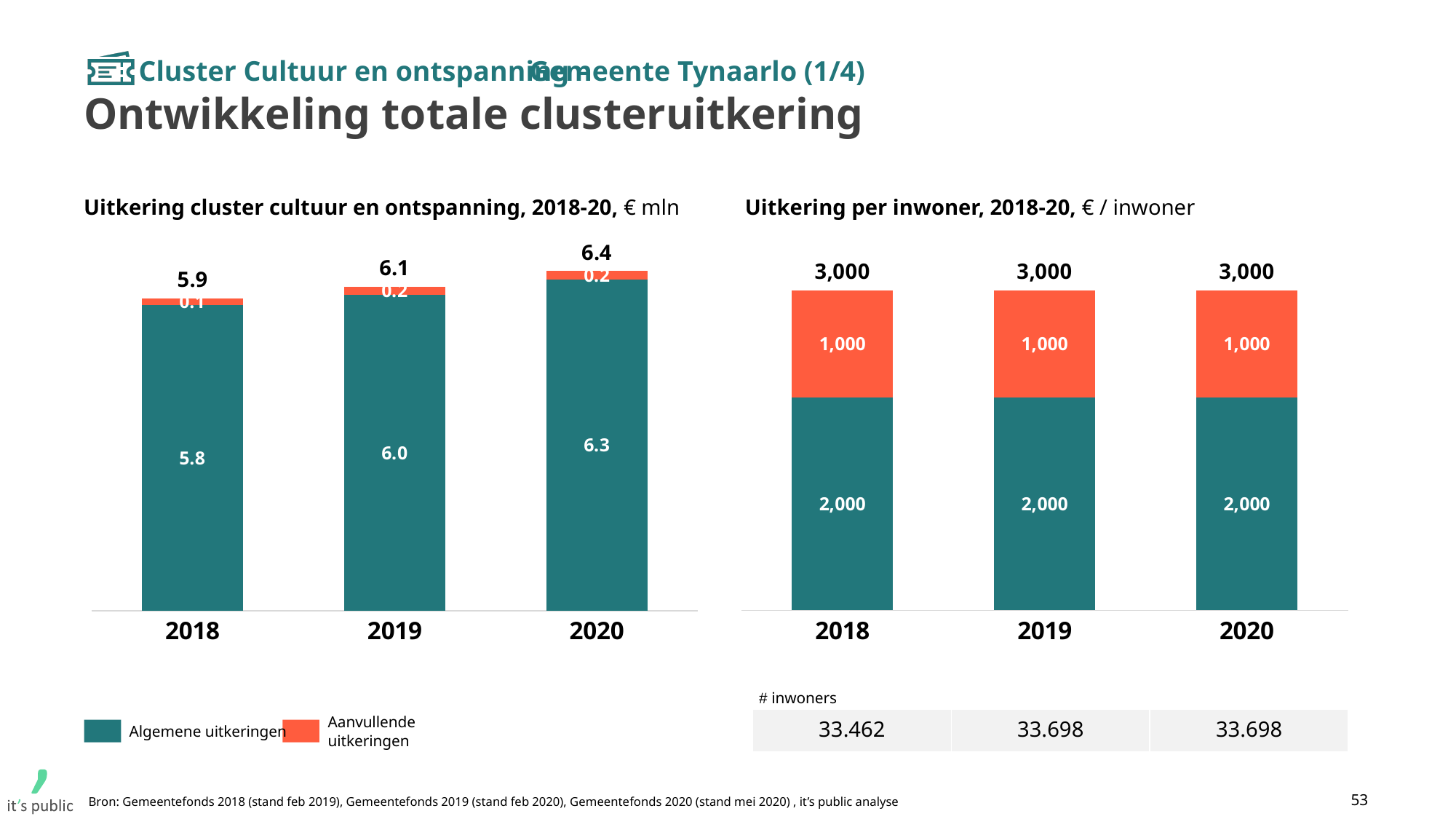
How many years are shown on the x axis of the chart 'Uitkering per inwoner, 2018-20'? 3 What kind of chart is 'Uitkering cluster cultuur en ontspanning, 2018-20'? stacked bar chart In the chart 'Uitkering per inwoner, 2018-20', what is the value of Algemene uitkeringen for 2019? 2,000 How many series does the legend on the slide list? 2 In the chart 'Uitkering cluster cultuur en ontspanning, 2018-20', is Algemene uitkeringen larger in 2019 or in 2018? 2019 In the chart 'Uitkering cluster cultuur en ontspanning, 2018-20', what is the total of the stacked bar for 2019? 6.1 In the chart 'Uitkering cluster cultuur en ontspanning, 2018-20', what is the difference between the total for 2020 and the total for 2018? 0.5 In the chart 'Uitkering cluster cultuur en ontspanning, 2018-20', what is the value of Aanvullende uitkeringen for 2018? 0.1 In the chart 'Uitkering per inwoner, 2018-20', what is the total of the stacked bar for 2020? 3,000 In the chart 'Uitkering cluster cultuur en ontspanning, 2018-20', which year has the highest total uitkering? 2020 In the chart 'Uitkering cluster cultuur en ontspanning, 2018-20', do the total values rise or fall from 2018 to 2020? rise In the chart 'Uitkering cluster cultuur en ontspanning, 2018-20', what is the value of Algemene uitkeringen for 2020? 6.3